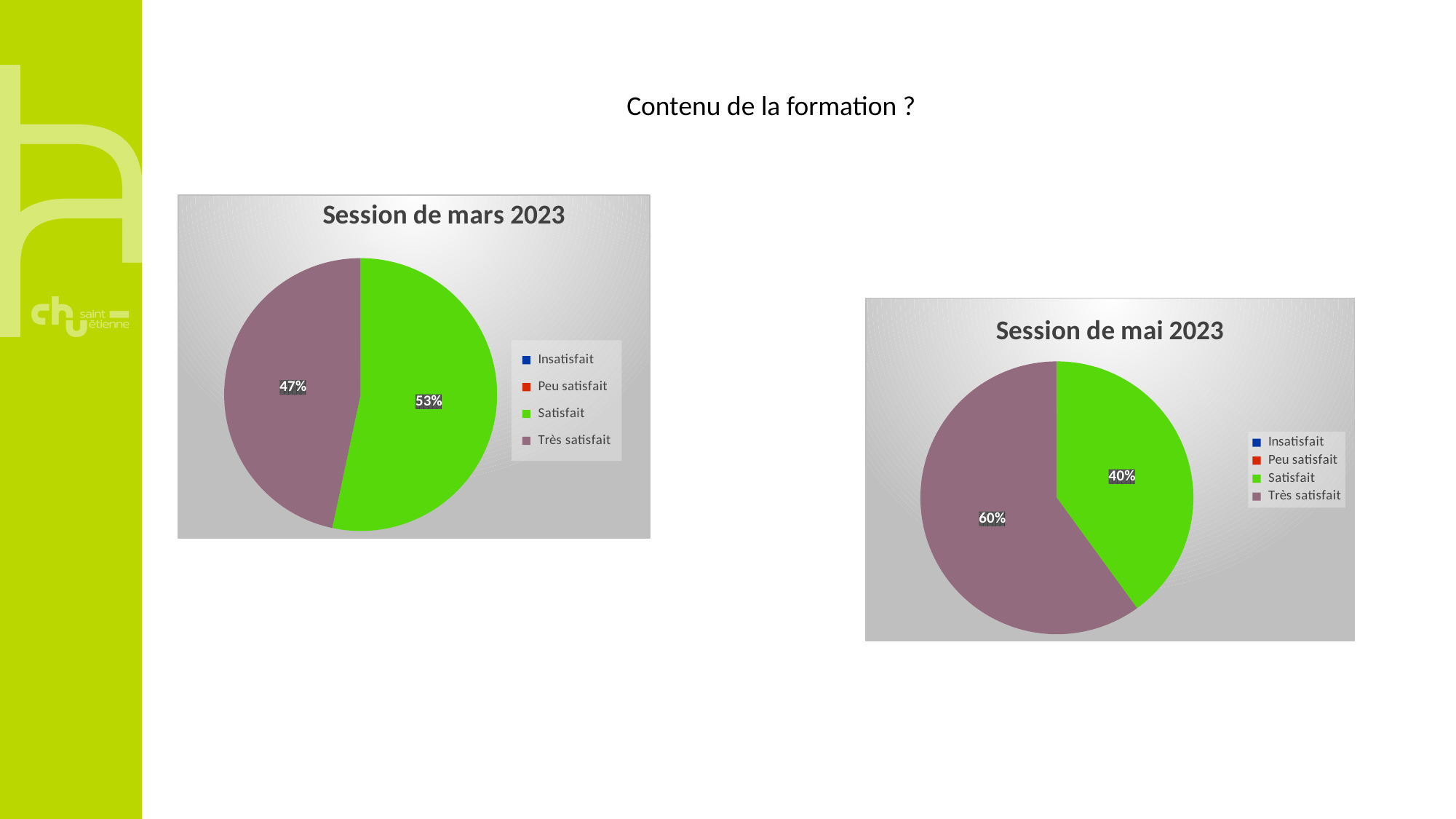
In the 'Session de mai 2023' chart, what share is labelled for Satisfait? 40% In the 'Session de mars 2023' chart, what is the difference between the Satisfait and Très satisfait shares? 6% In the 'Session de mars 2023' chart, what share is labelled for Très satisfait? 47% What type of chart is 'Session de mars 2023'? Pie chart In the 'Session de mars 2023' chart, which category has the largest slice? Satisfait In the 'Session de mars 2023' chart, what share is labelled for Satisfait? 53% In the 'Session de mai 2023' chart, what share is labelled for Très satisfait? 60% In the 'Session de mai 2023' chart, what is the difference between the Très satisfait and Satisfait shares? 20% In the 'Session de mai 2023' chart, which is larger: Satisfait or Très satisfait? Très satisfait In the 'Session de mars 2023' chart, what colour is the Très satisfait slice? Mauve (purple-grey) How many entries does the legend of the 'Session de mai 2023' chart list? 4 In the 'Session de mai 2023' chart, which category has the largest slice? Très satisfait